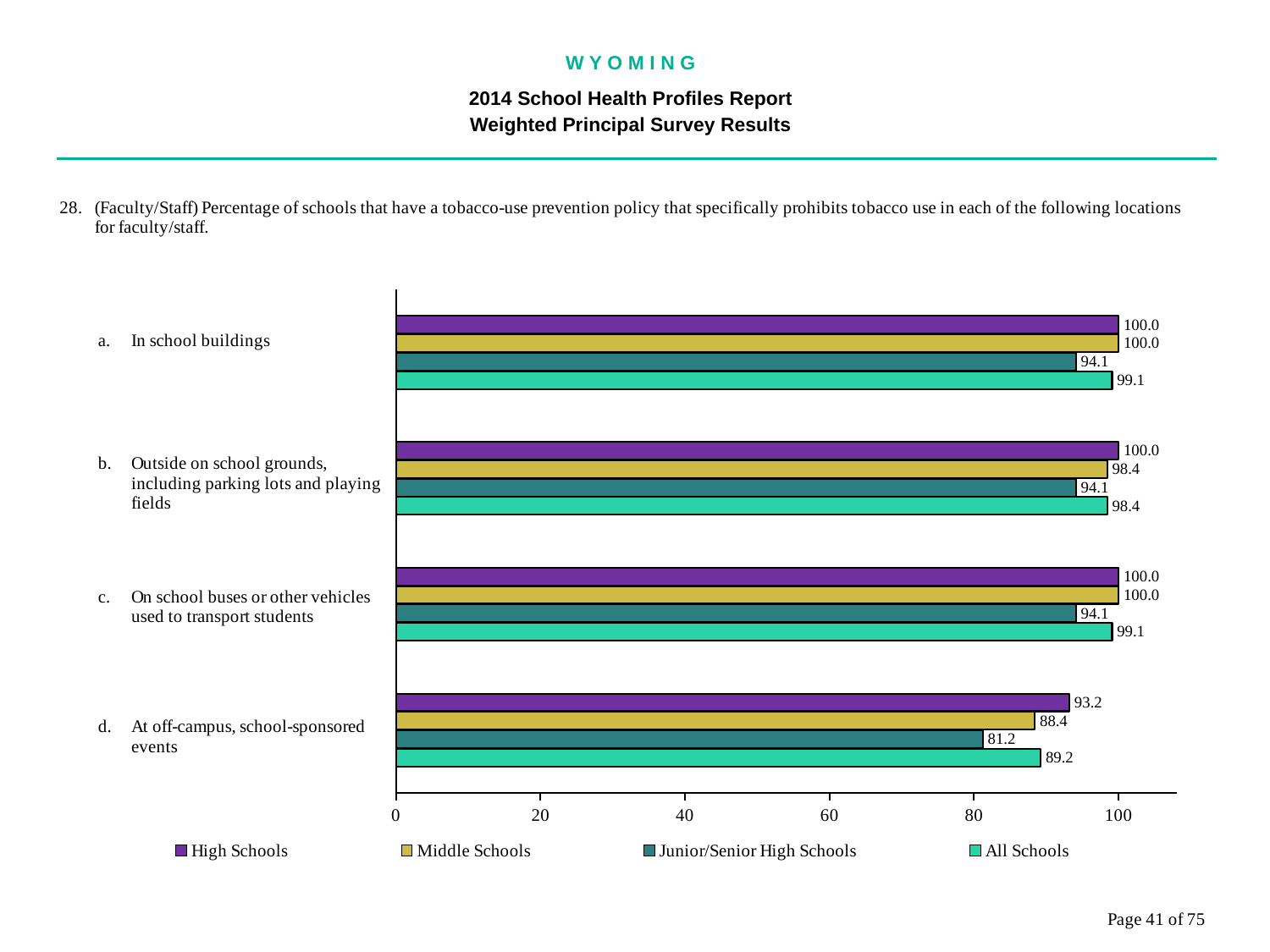
What is the value for High Schools for 'At off-campus, school-sponsored events'? 93.2 How many locations (categories) are shown on the chart? 4 What is the value for All Schools for 'Outside on school grounds, including parking lots and playing fields'? 98.4 Is the value for Middle Schools for 'At off-campus, school-sponsored events' greater or less than 80? greater What kind of chart is shown on the slide? Bar chart How many series does the legend list? 4 Which is larger for 'Outside on school grounds, including parking lots and playing fields': the Middle Schools value or the Junior/Senior High Schools value? Middle Schools What is the value for Junior/Senior High Schools for 'In school buildings'? 94.1 What is the value for Middle Schools for 'On school buses or other vehicles used to transport students'? 100.0 Which location has the lowest value for Junior/Senior High Schools? At off-campus, school-sponsored events What is the difference between the High Schools and Junior/Senior High Schools values for 'At off-campus, school-sponsored events'? 12.0 Which school type has the lowest value for 'At off-campus, school-sponsored events'? Junior/Senior High Schools